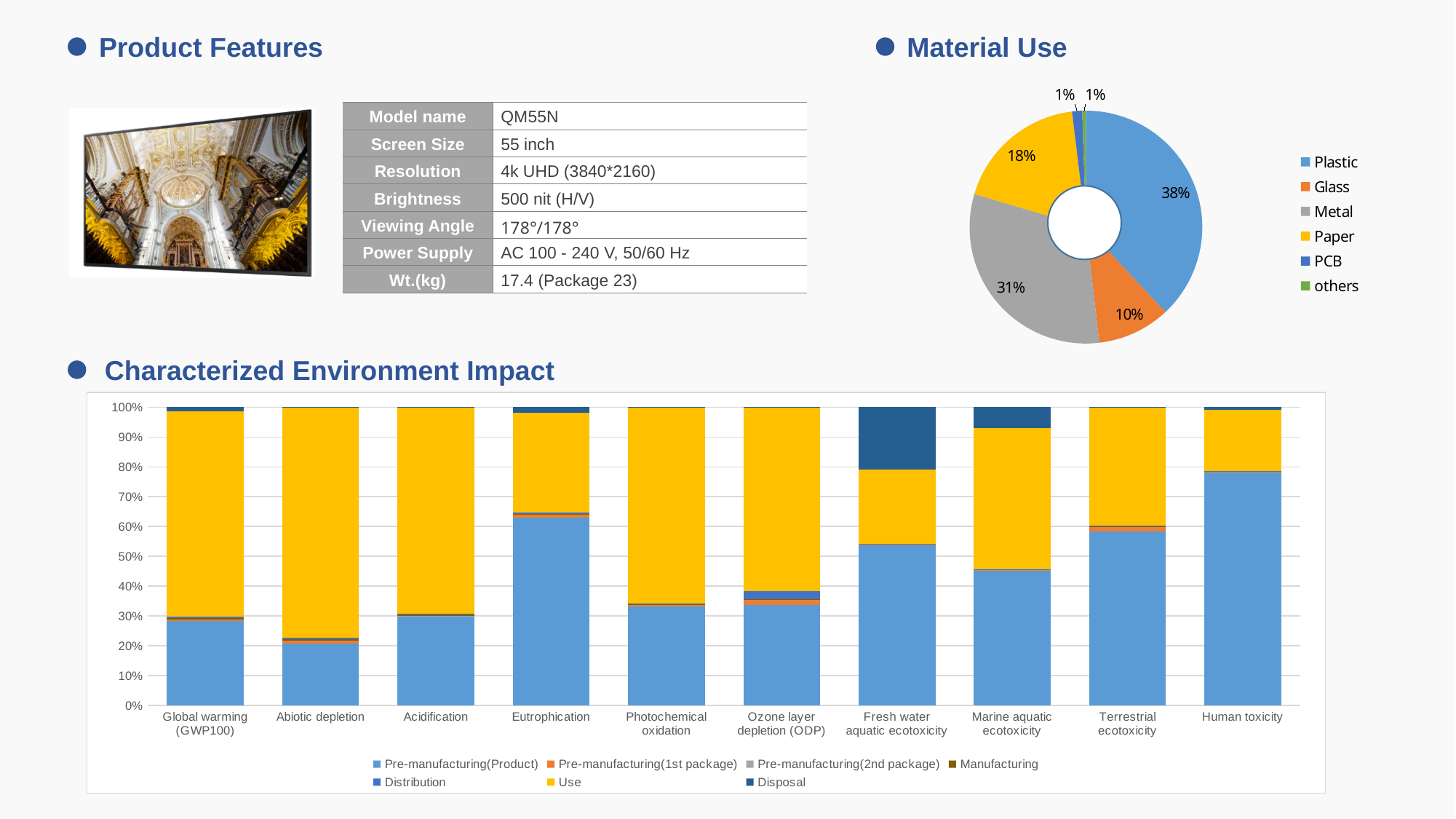
In the Material Use chart, which material has the largest share? Plastic In the Material Use chart, what percentage of material use is Plastic? 38% In the Material Use chart, which is larger, the share for Metal or the share for Paper? Metal How many series does the legend of the Characterized Environment Impact chart list? 7 What kind of chart is the Characterized Environment Impact chart? Stacked bar chart What kind of chart is the Material Use chart? Pie chart How many categories are shown on the x axis of the Characterized Environment Impact chart? 10 In the Material Use chart, what percentage of material use is Metal? 31% In the Characterized Environment Impact chart, is the Pre-manufacturing(Product) share for Human toxicity greater or less than 70%? greater How many entries does the legend of the Material Use chart list? 6 In the Material Use chart, what is the difference in percentage points between Paper and Glass? 8 In the Material Use chart, what percentage of material use is Glass? 10%